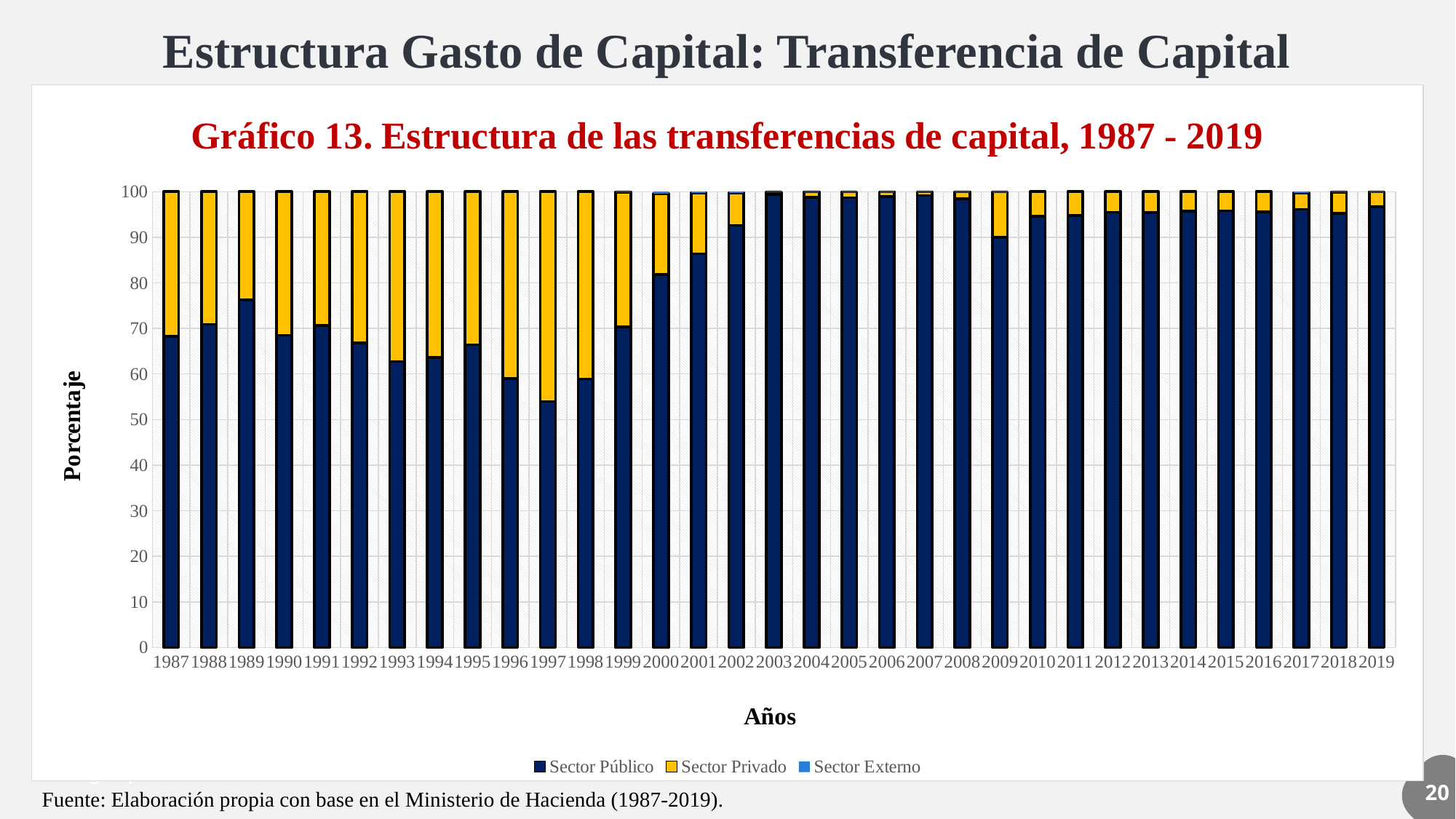
What is the label of the y axis? Porcentaje Which year has a larger Sector Público share, 1987 or 1989? 1989 Is the Sector Público value for 1993 greater or less than 70? less What kind of chart is shown on the slide? Stacked bar chart Is the Sector Público value for 2010 greater or less than 90? greater How many years (bars) are plotted on the x axis? 33 Is the Sector Público value for 1997 greater or less than 60? less In which year is the Sector Privado share the largest? 1997 Does the Sector Público share generally rise or fall from 1987 to 2019? rise In which year is the Sector Público share the lowest? 1997 How many series does the legend list? 3